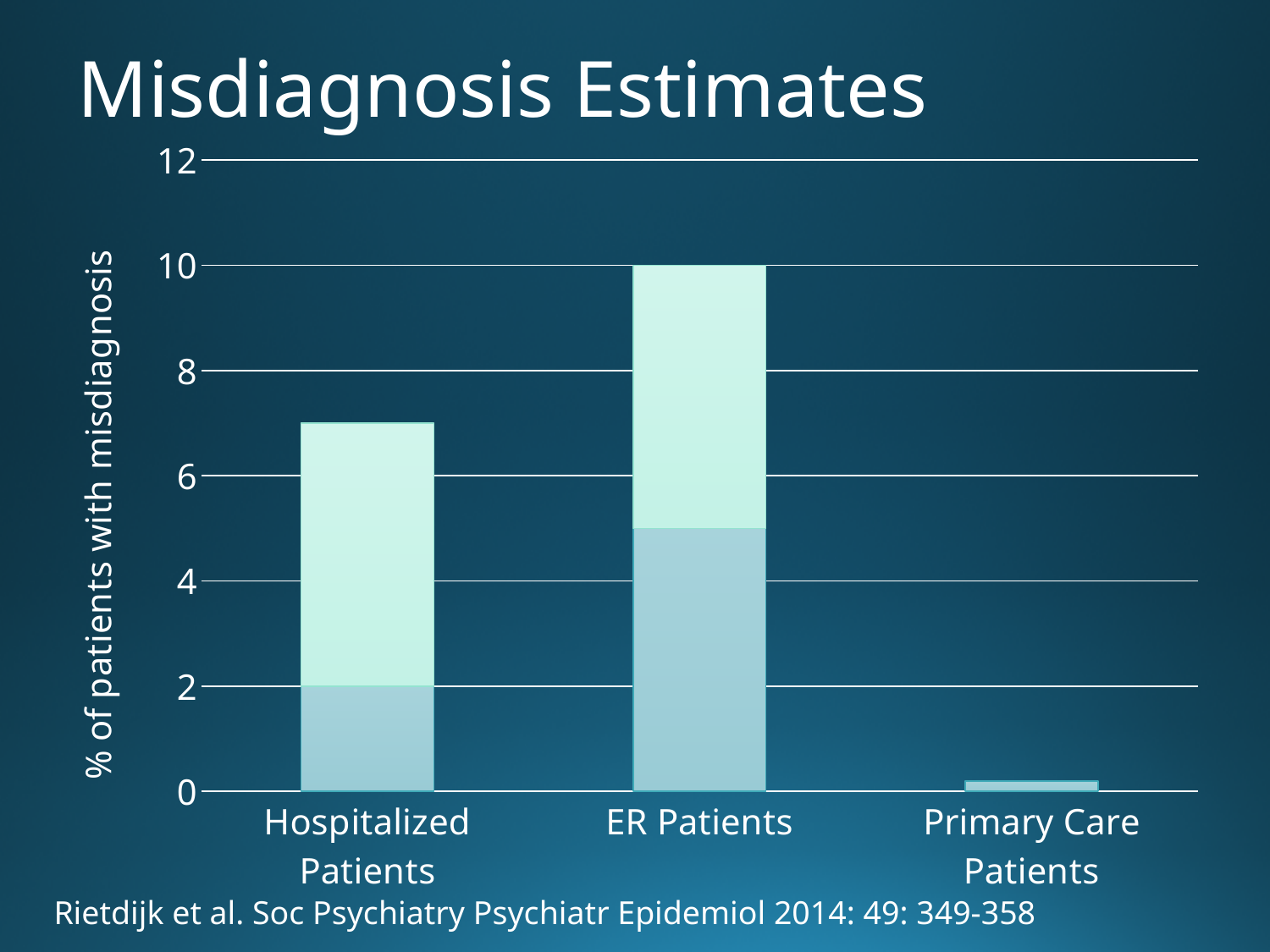
What is the label on the vertical axis? % of patients with misdiagnosis Which category has the lowest total bar? Primary Care Patients Which is larger, the total bar for ER Patients or for Hospitalized Patients? ER Patients How many patient categories are shown on the x axis? 3 Is the total value for Hospitalized Patients greater or less than 8? less Which category has the highest total bar? ER Patients What value does the lower (darker) segment of the Hospitalized Patients bar reach? 2 What kind of chart is shown on the slide? Stacked bar chart Is the total value for Hospitalized Patients greater or less than 6? greater What is the total height of the ER Patients bar? 10 Is the value for Primary Care Patients greater or less than 2? less What is the title of the chart? Misdiagnosis Estimates